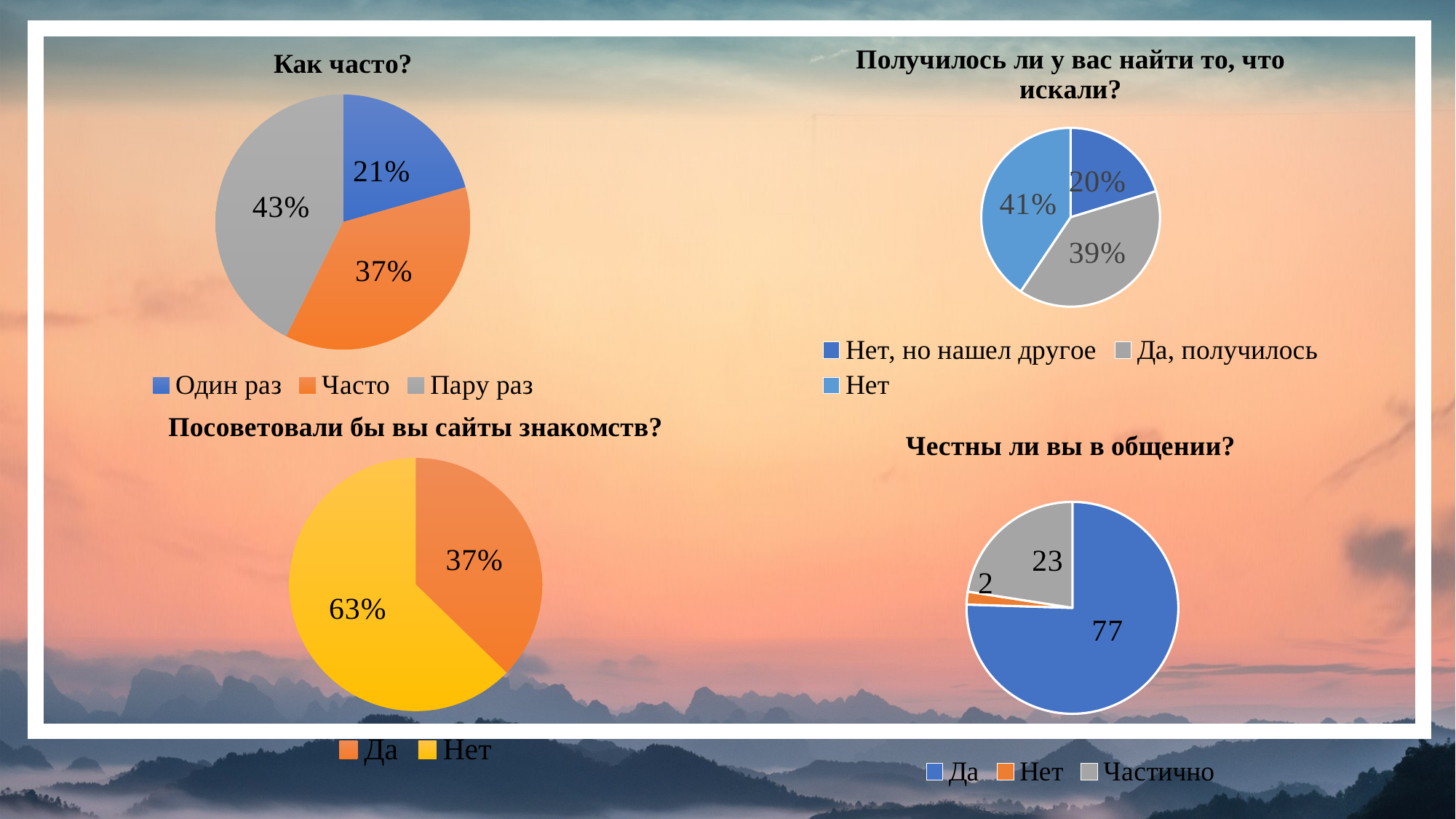
In the chart titled "Посоветовали бы вы сайты знакомств?", which is larger, "Да" or "Нет"? Нет In the chart titled "Получилось ли у вас найти то, что искали?", which category has the largest slice? Нет In the chart titled "Получилось ли у вас найти то, что искали?", what is the value for "Да, получилось"? 39% In the chart titled "Получилось ли у вас найти то, что искали?", how many categories does the legend list? 3 In the chart titled "Как часто?", what is the value for "Пару раз"? 43% In the chart titled "Честны ли вы в общении?", what is the value for "Да"? 77 In the chart titled "Как часто?", which category has the smallest slice? Один раз In the chart titled "Честны ли вы в общении?", which category has the smallest slice? Нет What type of chart is used for "Посоветовали бы вы сайты знакомств?"? Pie chart In the chart titled "Как часто?", what is the difference between "Пару раз" and "Часто"? 6% In the chart titled "Посоветовали бы вы сайты знакомств?", what is the value for "Нет"? 63% In the chart titled "Честны ли вы в общении?", what is the difference between "Да" and "Частично"? 54